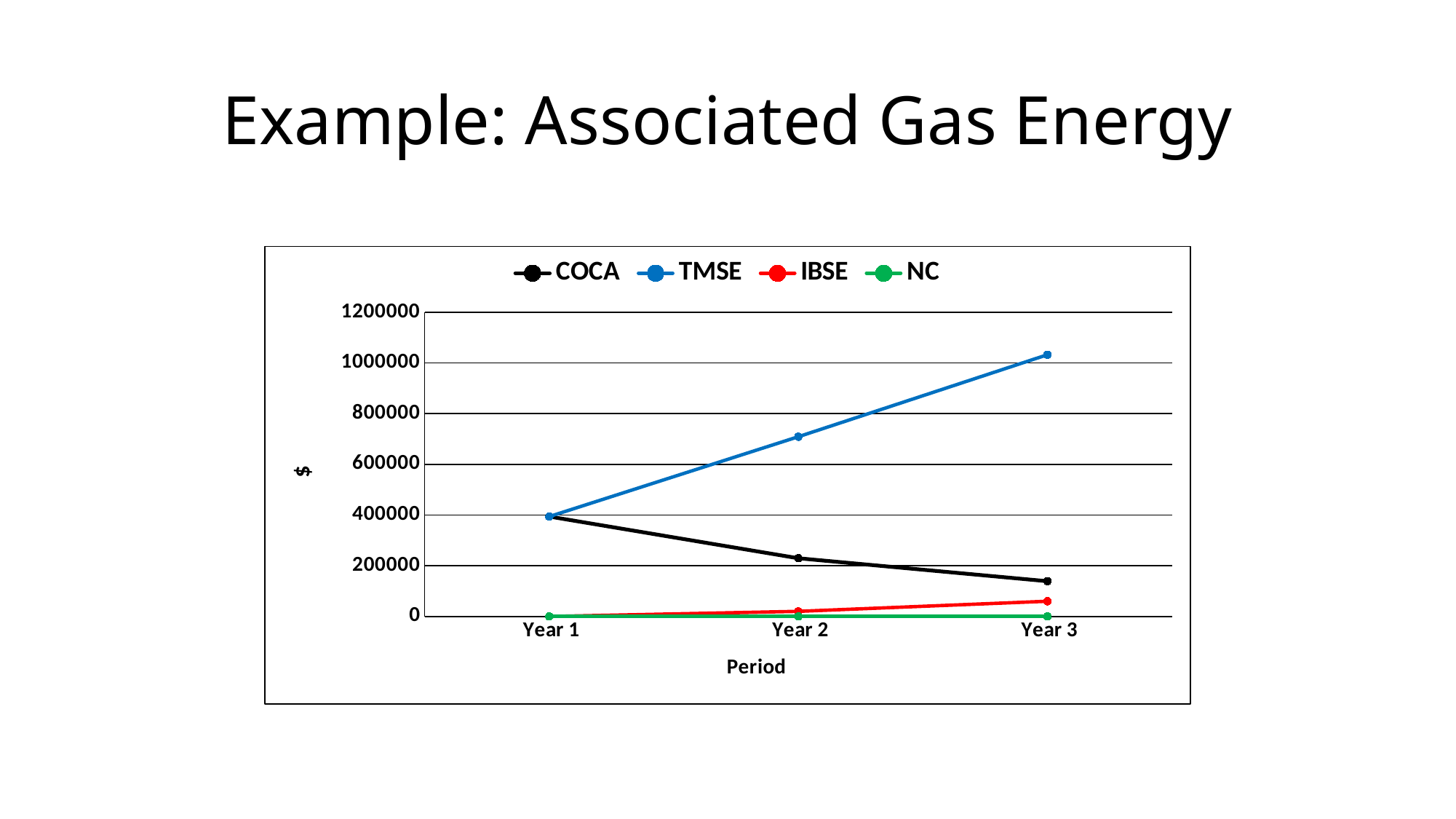
Is the value for TMSE in Year 3 greater or less than 800000? greater Does the TMSE line rise or fall from Year 1 to Year 3? rise Is the value for COCA in Year 3 greater or less than 200000? less Does the COCA line rise or fall from Year 1 to Year 3? fall In Year 3, which is larger, IBSE or NC? IBSE What is the title of the x axis? Period How many series does the legend list? 4 Which series has the highest value in Year 3? TMSE How many periods are plotted along the x axis? 3 What kind of chart is shown on the slide? line chart In Year 2, which is larger, TMSE or COCA? TMSE Which series has the lowest value in Year 3? NC